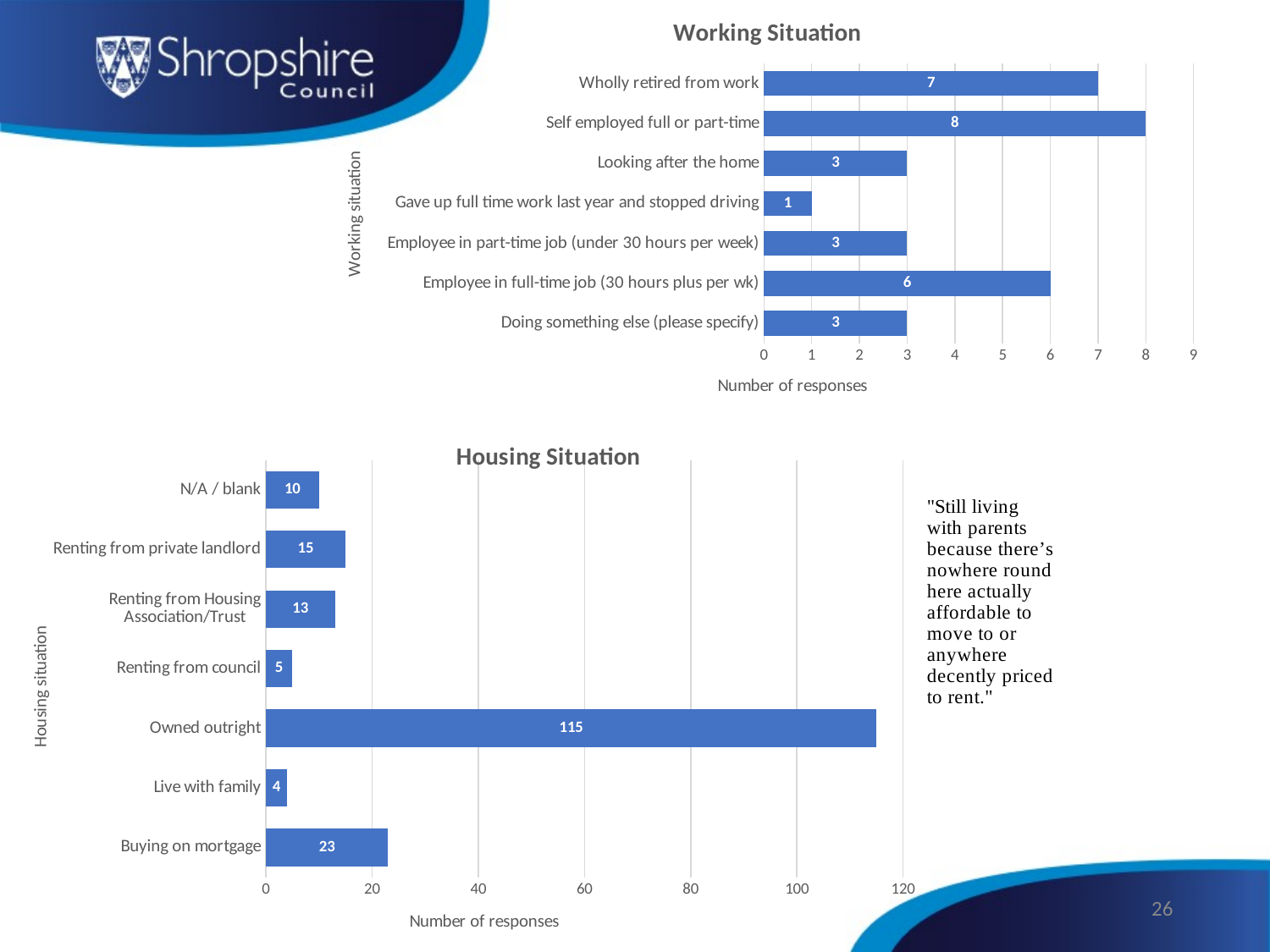
In the Housing Situation chart, which category has the lowest number of responses? Live with family What is the x-axis label of the Working Situation chart? Number of responses In the Housing Situation chart, is the value for 'Owned outright' greater or less than 100? greater In the Housing Situation chart, how many responses are there for 'Owned outright'? 115 In the Housing Situation chart, which has more responses: 'Renting from private landlord' or 'Renting from Housing Association/Trust'? Renting from private landlord In the Housing Situation chart, what is the difference in responses between 'Buying on mortgage' and 'Renting from council'? 18 In the Working Situation chart, what is the difference in responses between 'Wholly retired from work' and 'Employee in full-time job (30 hours plus per wk)'? 1 In the Working Situation chart, how many responses are there for 'Self employed full or part-time'? 8 What type of chart is the Housing Situation chart? Bar chart In the Working Situation chart, which category has the highest number of responses? Self employed full or part-time In the Working Situation chart, how many categories are shown? 7 In the Working Situation chart, which category has the lowest number of responses? Gave up full time work last year and stopped driving